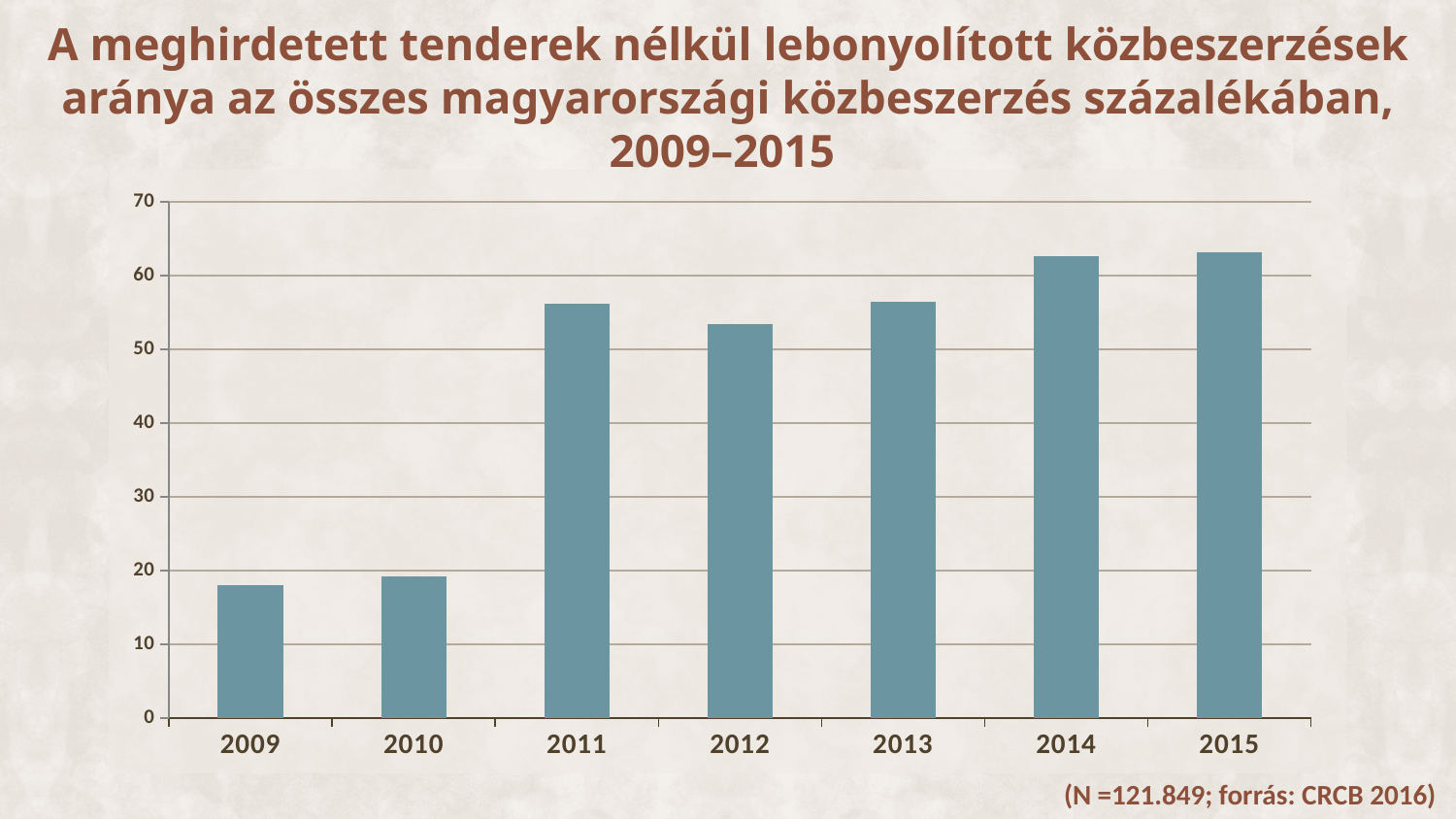
Is the value for 2011 greater or less than 50? greater Is the value for 2009 greater or less than 20? less Is the value for 2014 greater or less than 60? greater How many years are shown on the x axis of the chart? 7 What kind of chart is shown on the slide? bar chart What is the highest value shown on the y axis of the chart? 70 Which year has the larger value, 2011 or 2012? 2011 Which year has the larger value, 2010 or 2014? 2014 Do the values generally rise or fall from 2009 to 2015? rise